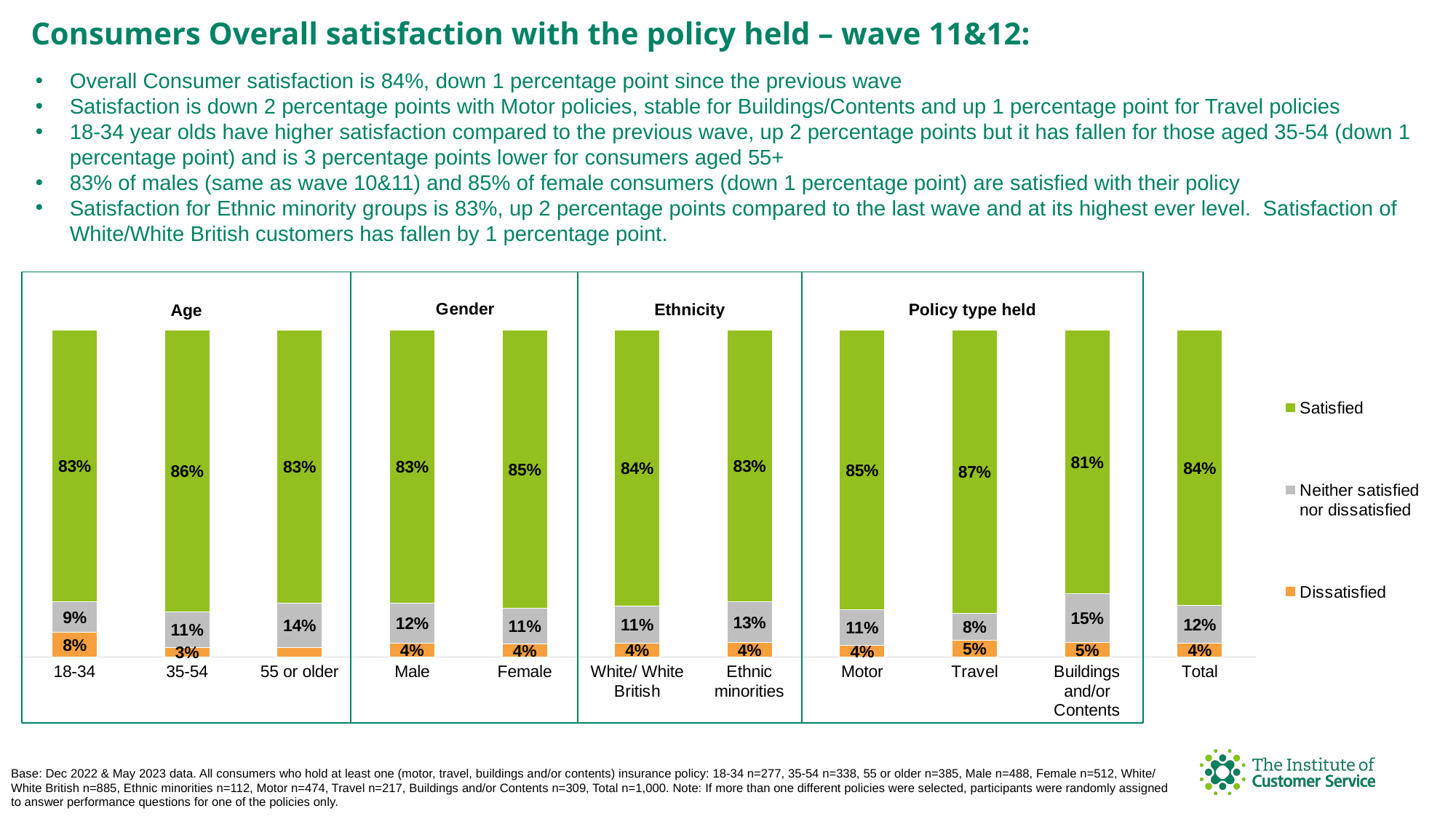
Which category has the highest Satisfied percentage? Travel Which category has the lowest Satisfied percentage? Buildings and/or Contents What is the Neither satisfied nor dissatisfied value for Buildings and/or Contents? 15% What kind of chart is this? Stacked bar chart What is the Dissatisfied value for the 18-34 age group? 8% Which has a higher Neither satisfied nor dissatisfied percentage, 55 or older or 35-54? 55 or older What percentage of 35-54 year olds are satisfied with their policy? 86% How many categories are shown on the x axis? 11 How many series does the legend list? 3 Which colour represents the Dissatisfied series? Orange What is the difference between the Satisfied percentage for Female and Male? 2% What is the total of the Satisfied, Neither and Dissatisfied values for the Total bar? 100%